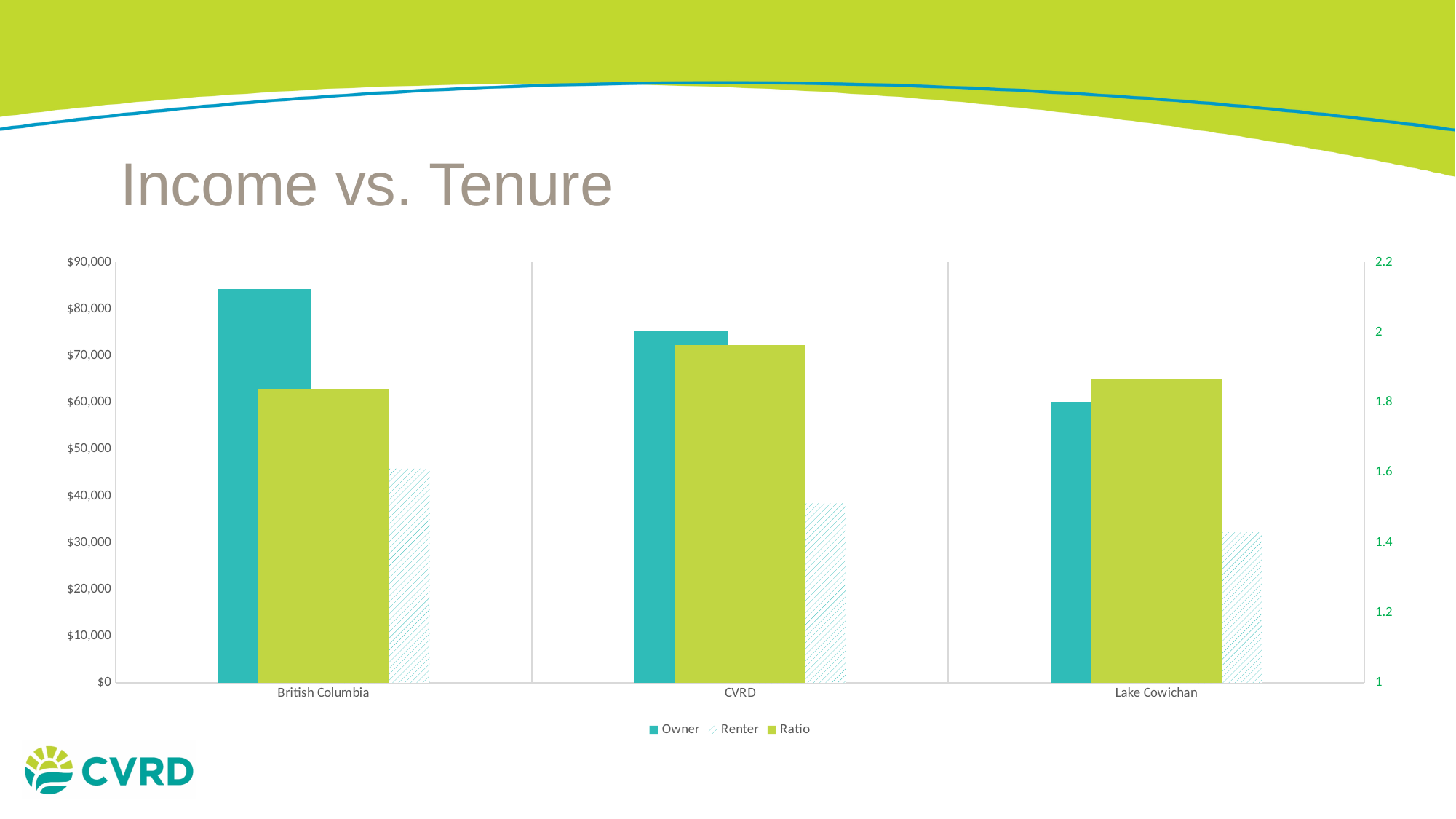
Which is larger for CVRD, the Owner value or the Renter value? Owner What is the title of the slide? Income vs. Tenure Is the Renter value for Lake Cowichan greater or less than $40,000? less Do the Owner values rise or fall moving from British Columbia to Lake Cowichan? fall Is the Owner value for British Columbia greater or less than $80,000? greater Which category has the lowest Owner value? Lake Cowichan Is the Ratio value for CVRD greater or less than 1.8? greater How many series does the legend list? 3 What kind of chart is shown on the slide? bar chart Which category has the highest Ratio value? CVRD Which category has the highest Owner value? British Columbia How many categories are shown on the x axis? 3